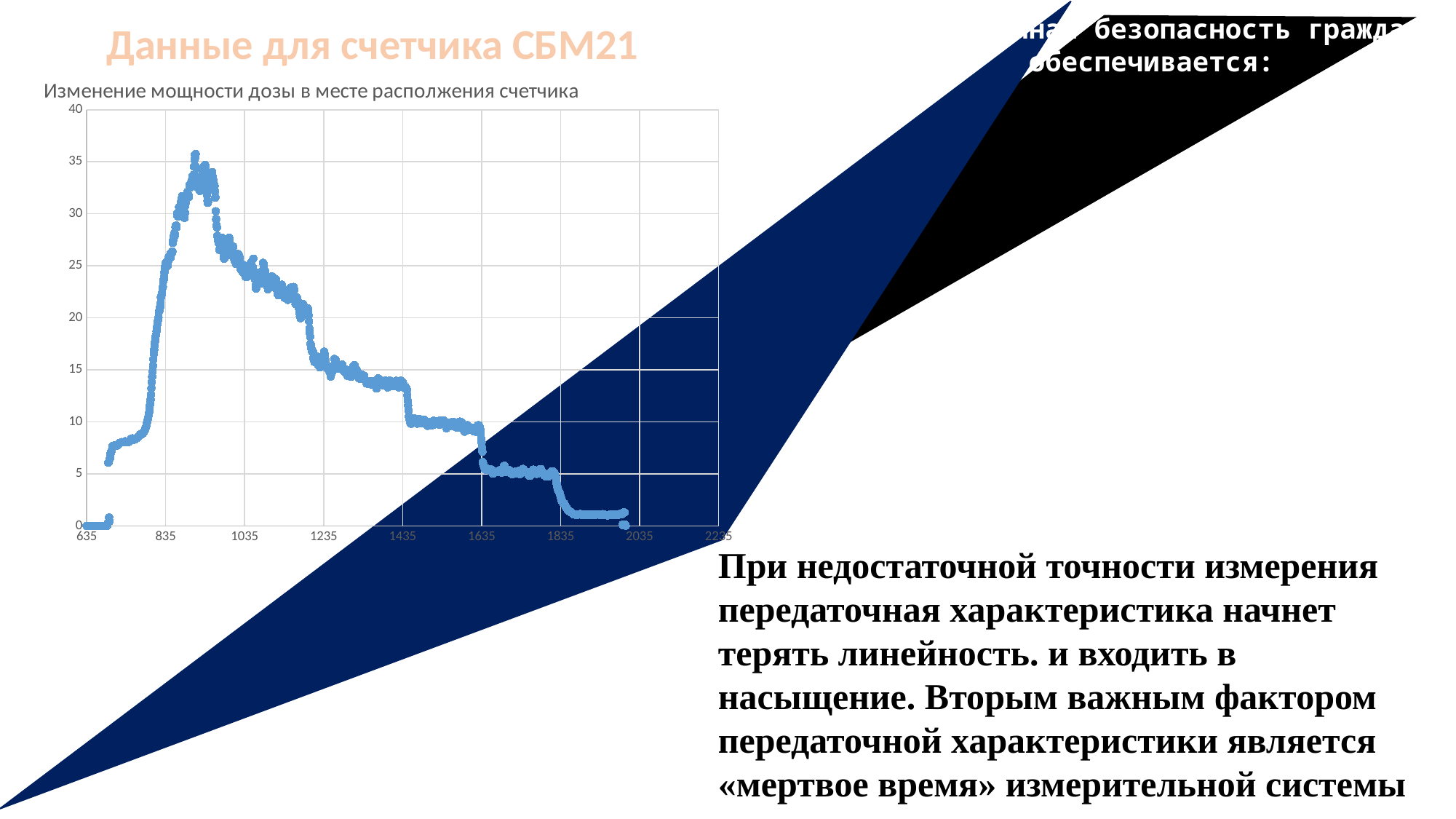
Is the peak value of the plotted data greater or less than 30? greater Is the value at x = 1435 greater or less than 15? less What kind of chart is shown on the slide? scatter chart What is the title of the chart? Изменение мощности дозы в месте располжения счетчика Is the value at x = 1035 greater or less than 20? greater What is the highest value shown on the chart's vertical axis? 40 Do the plotted values rise or fall along the x axis between 1035 and 2035? fall Do the plotted values rise or fall along the x axis between 635 and 835? rise What is the last tick label on the chart's horizontal axis? 2235